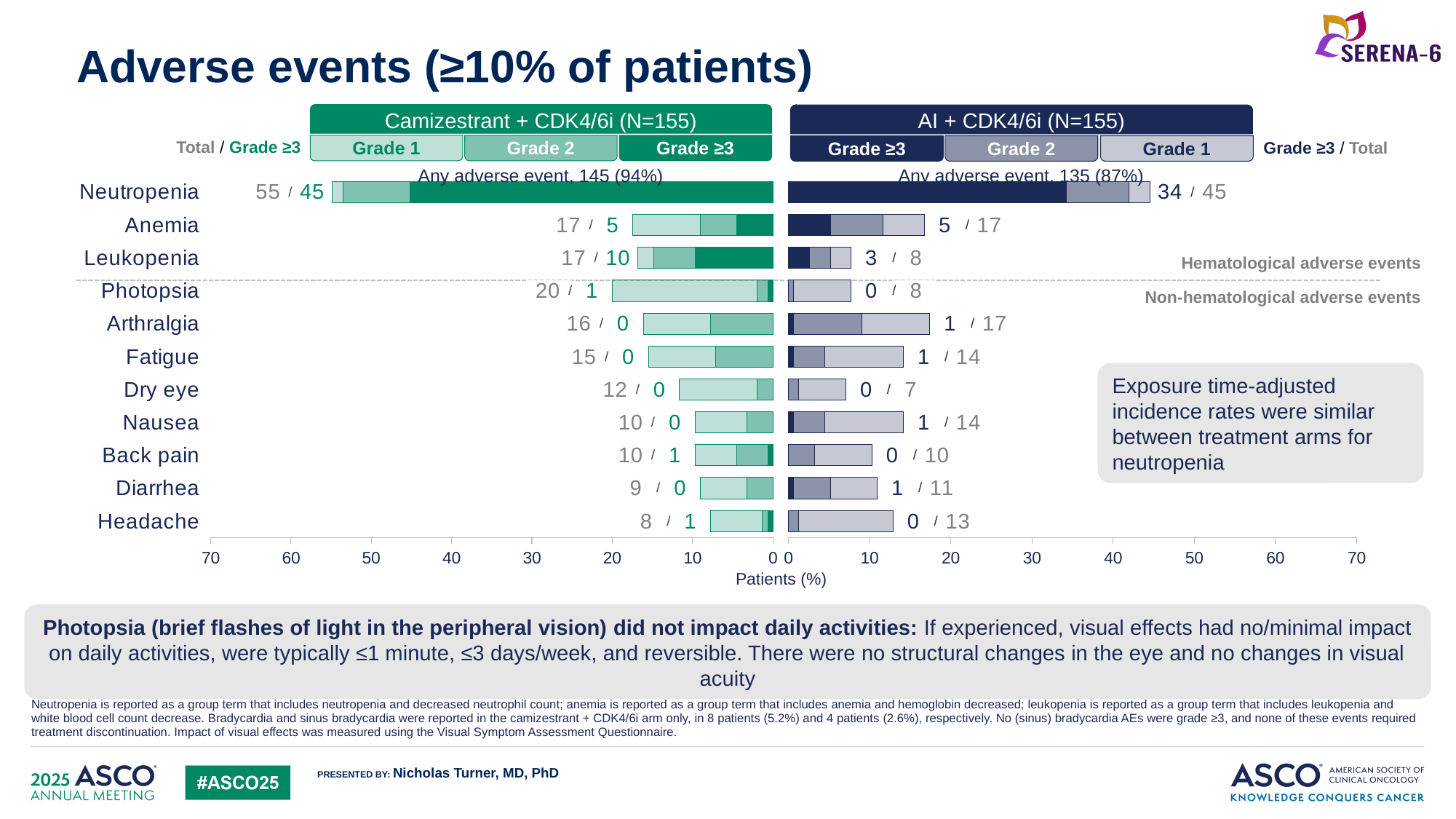
How many adverse events are listed in the chart? 11 Which arm has a higher total percentage of patients with arthralgia, camizestrant + CDK4/6i or AI + CDK4/6i? AI + CDK4/6i Which adverse event has the highest total percentage in the camizestrant + CDK4/6i arm? Neutropenia What is the total percentage of patients with photopsia in the camizestrant + CDK4/6i arm? 20 What is the grade ≥3 percentage for leukopenia in the camizestrant + CDK4/6i arm? 10 What is the total percentage of patients with neutropenia in the camizestrant + CDK4/6i arm? 55 What is the difference between the total percentage of photopsia in the camizestrant + CDK4/6i arm and in the AI + CDK4/6i arm? 12 How many grade categories are shown in the legend for each treatment arm? 3 What is the grade ≥3 percentage for neutropenia in the AI + CDK4/6i arm? 34 Which adverse event has the lowest total percentage in the AI + CDK4/6i arm? Dry eye What kind of chart is shown on the slide? Stacked bar chart What percentage of patients had any adverse event in the AI + CDK4/6i arm? 87%